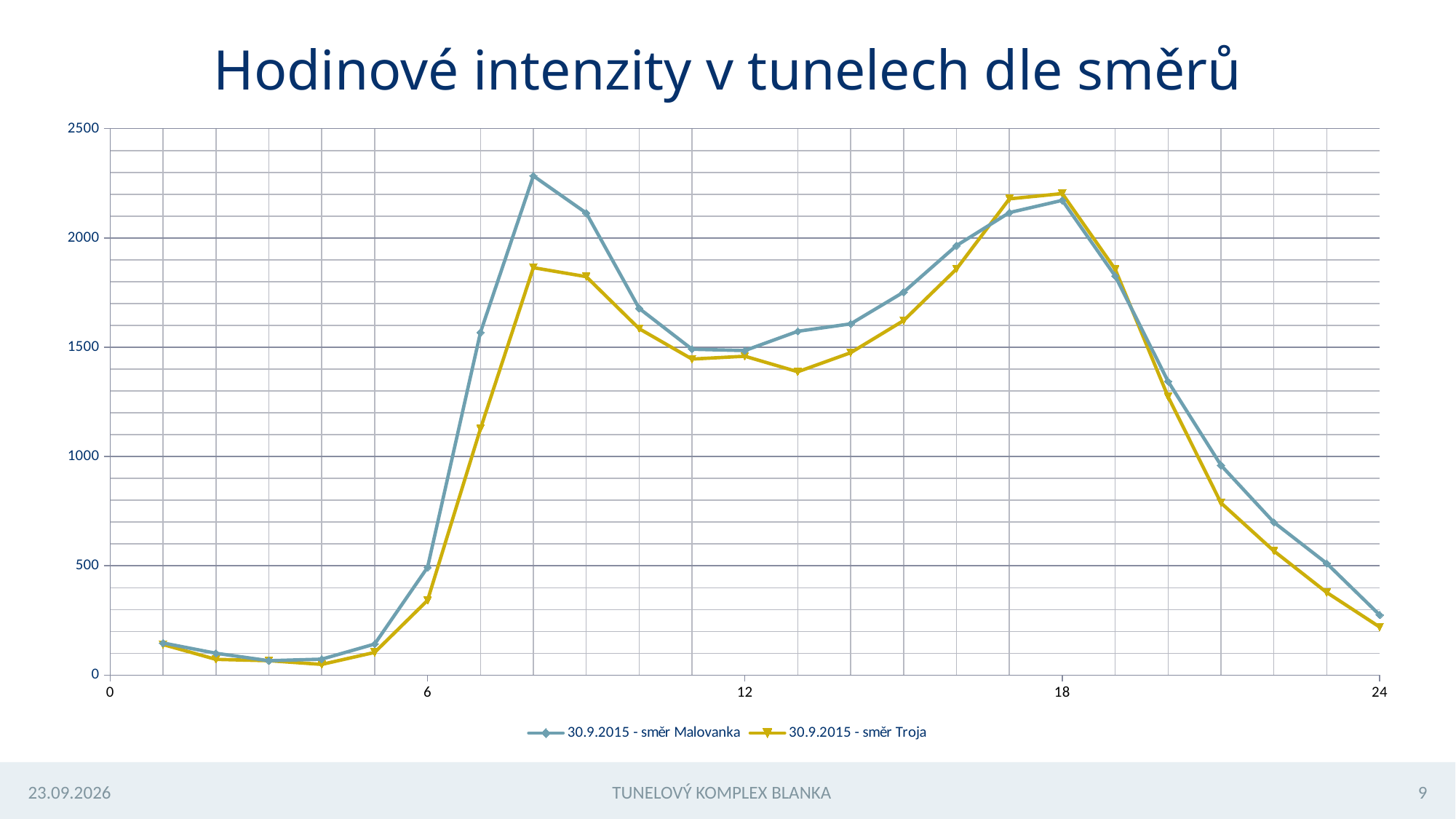
What is the title of the chart? Hodinové intenzity v tunelech dle směrů How many data points does each series have? 24 At which hour does the 30.9.2015 - směr Troja series reach its lowest value? 4 What kind of chart is shown on the slide? line chart Do the values of both series rise or fall between hour 18 and hour 24? fall Is the value for 30.9.2015 - směr Troja at hour 13 greater or less than 1500? less How many series does the legend list? 2 At which hour does the 30.9.2015 - směr Malovanka series reach its highest value? 8 Is the value for 30.9.2015 - směr Troja at hour 8 greater or less than 2000? less Is the value for 30.9.2015 - směr Malovanka at hour 8 greater or less than 2000? greater At hour 8, which series has the larger value, směr Malovanka or směr Troja? směr Malovanka What are the two series named in the legend? 30.9.2015 - směr Malovanka; 30.9.2015 - směr Troja